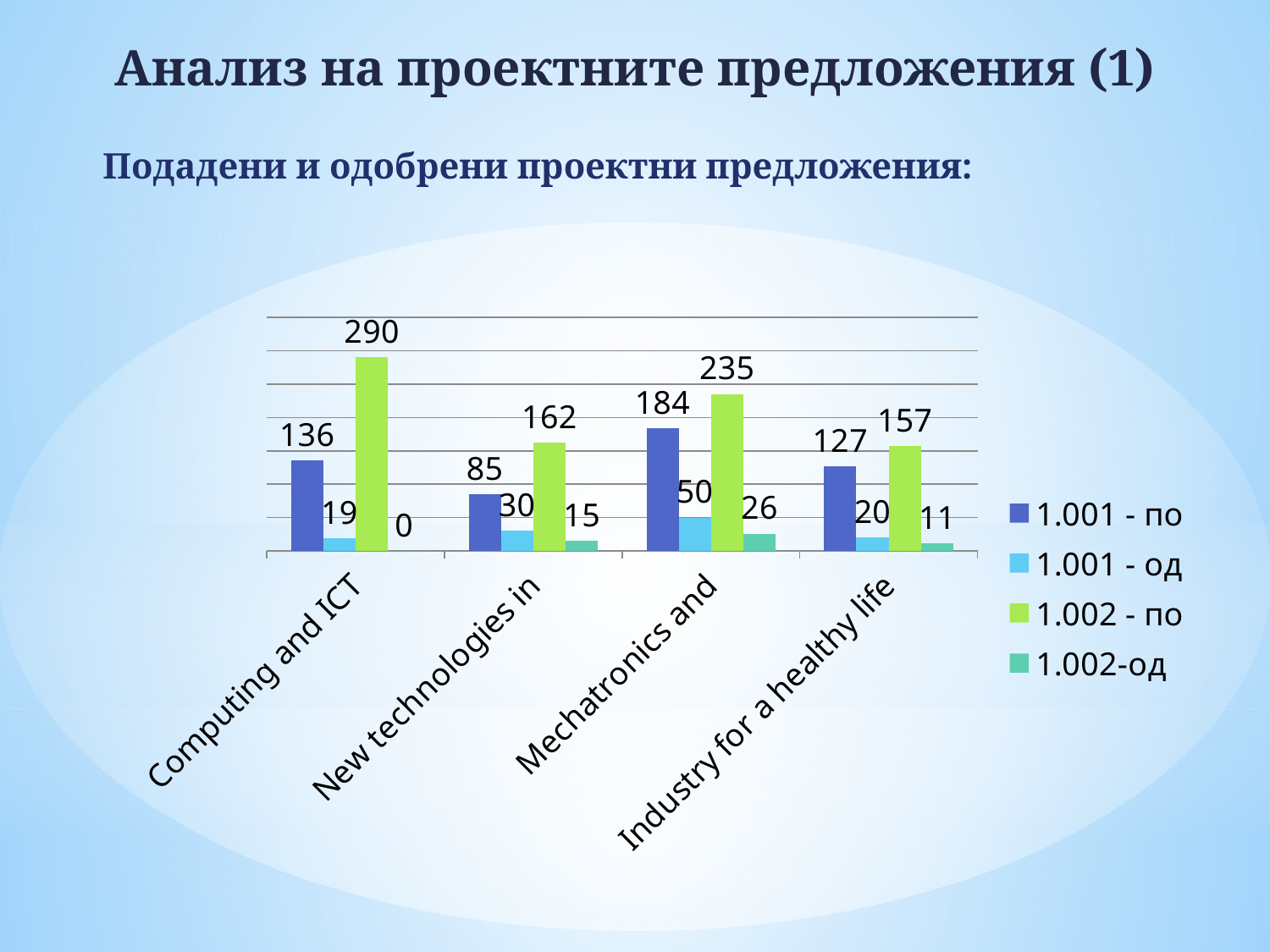
What is the value of the "1.002 - по" series for Computing and ICT? 290 What colour are the bars of the "1.002 - по" series? green What type of chart is shown on the slide? bar chart How many categories are shown on the x axis? 4 How many series does the legend list? 4 Which is larger for Industry for a healthy life: the "1.001 - од" value or the "1.002-од" value? 1.001 - од What is the difference between the "1.002 - по" and "1.001 - по" values for Computing and ICT? 154 What is the value of the "1.001 - по" series for Industry for a healthy life? 127 What is the value of the "1.002-од" series for Computing and ICT? 0 What is the value of the "1.001 - од" series for Mechatronics and? 50 Which category has the highest value in the "1.001 - по" series? Mechatronics and Which category has the lowest value in the "1.002 - по" series? Industry for a healthy life